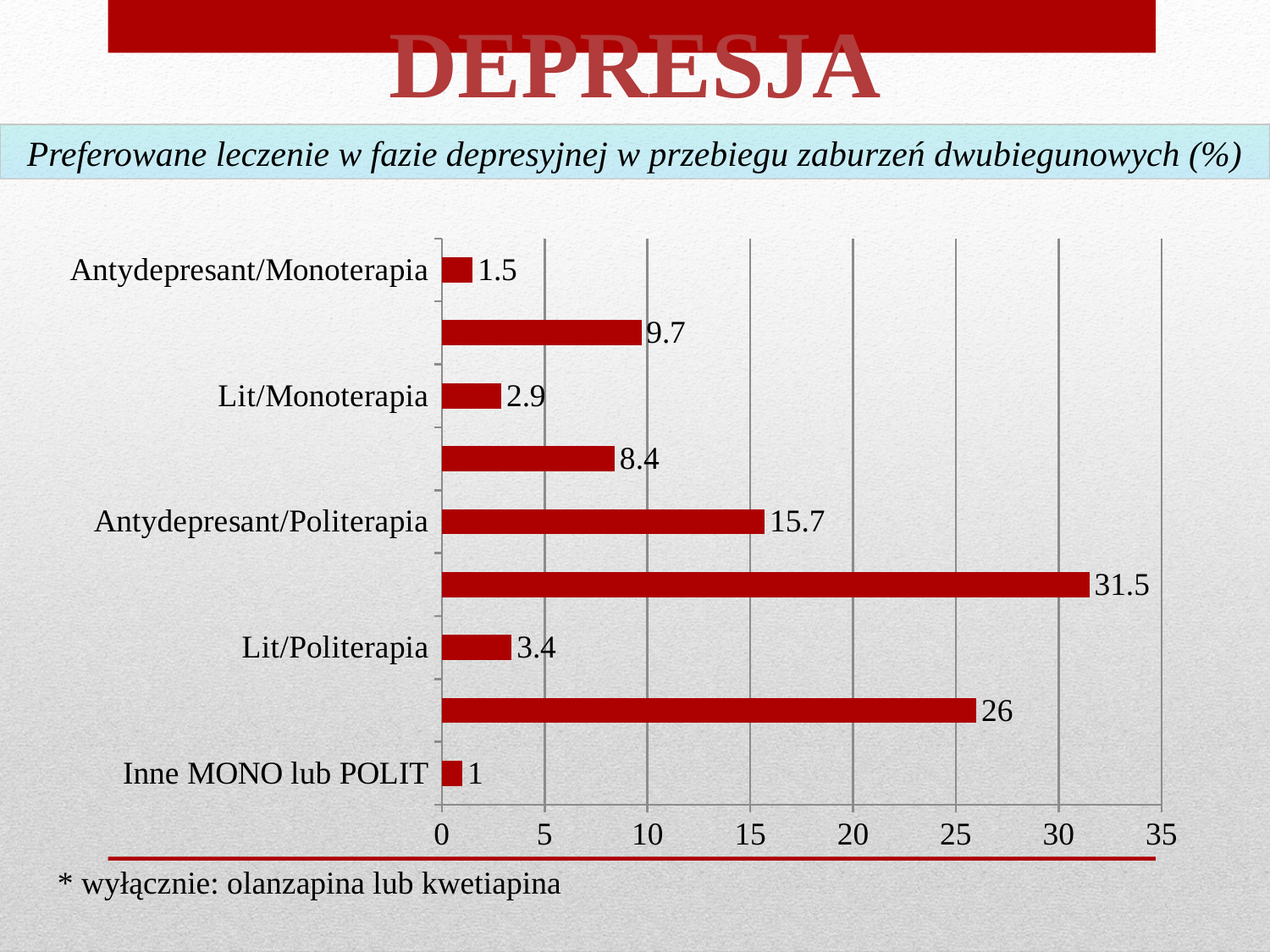
What is the difference between the values for Antydepresant/Politerapia and Lit/Politerapia? 12.3 What is the value for Lit/Politerapia? 3.4 Which category has the lowest value in the chart? Inne MONO lub POLIT What is the value for Antydepresant/Monoterapia? 1.5 What is the value for Inne MONO lub POLIT? 1 Which is larger, the value for Antydepresant/Politerapia or the value for Lit/Politerapia? Antydepresant/Politerapia What is the value for Lit/Monoterapia? 2.9 How many bars are plotted in the chart? 9 What is the value for Antydepresant/Politerapia? 15.7 What is the difference between the values for Lit/Monoterapia and Antydepresant/Monoterapia? 1.4 What is the maximum value shown on the horizontal axis of the chart? 35 What kind of chart is shown on the slide? bar chart